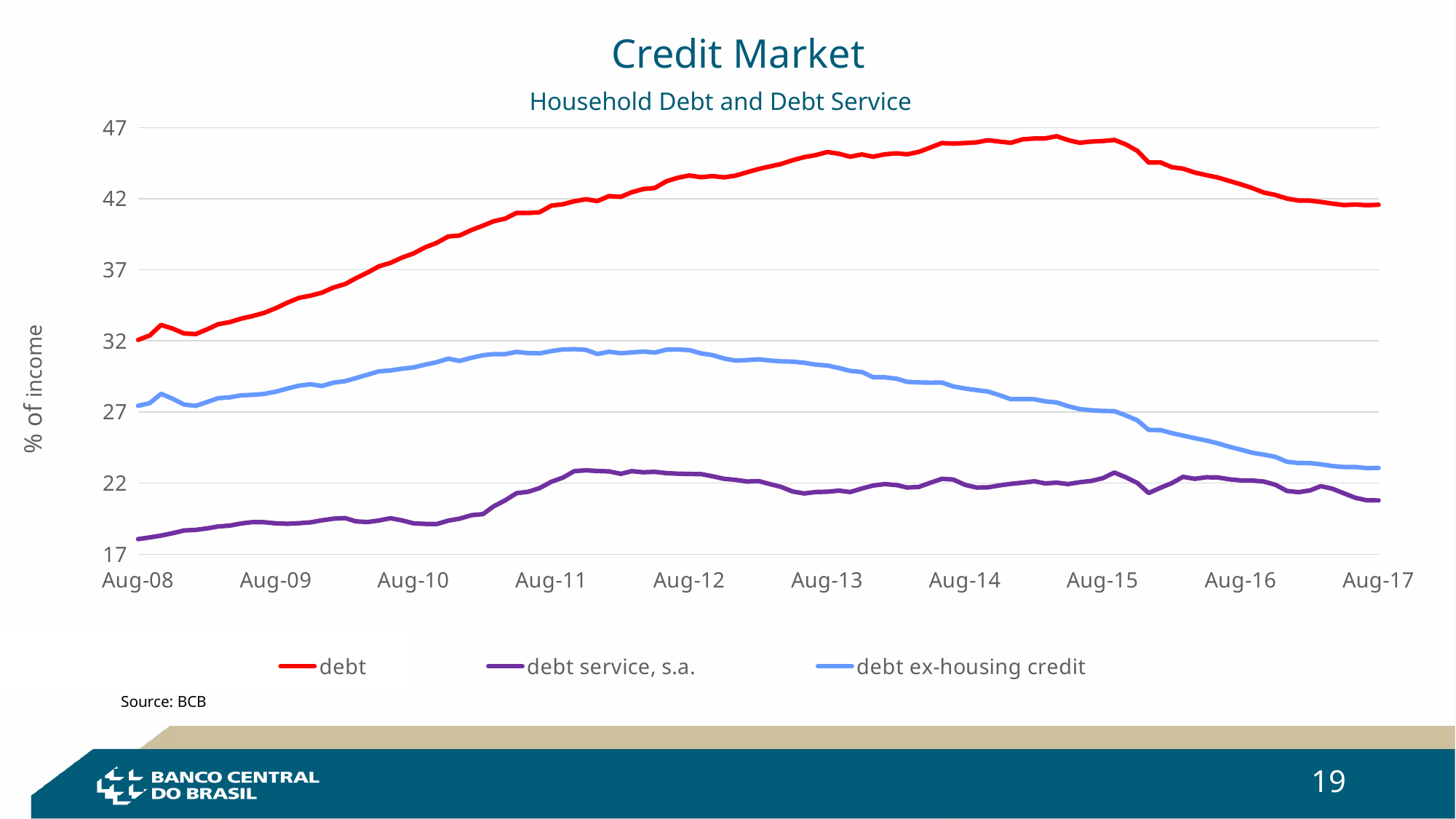
Is the value for debt at Aug-10 greater or less than 37? greater Does the debt ex-housing credit series rise or fall between Aug-12 and Aug-17? fall How many series does the legend list? 3 What is the label on the vertical axis? % of income Which series has the highest values throughout the chart? debt Does the debt series rise or fall between Aug-08 and Aug-15? rise Is the value for debt at Aug-15 greater or less than 42? greater Is the value for debt ex-housing credit at Aug-17 greater or less than 27? less What is the subtitle of the chart? Household Debt and Debt Service What kind of chart is shown on the slide? line chart Which series has the lowest values throughout the chart? debt service, s.a.